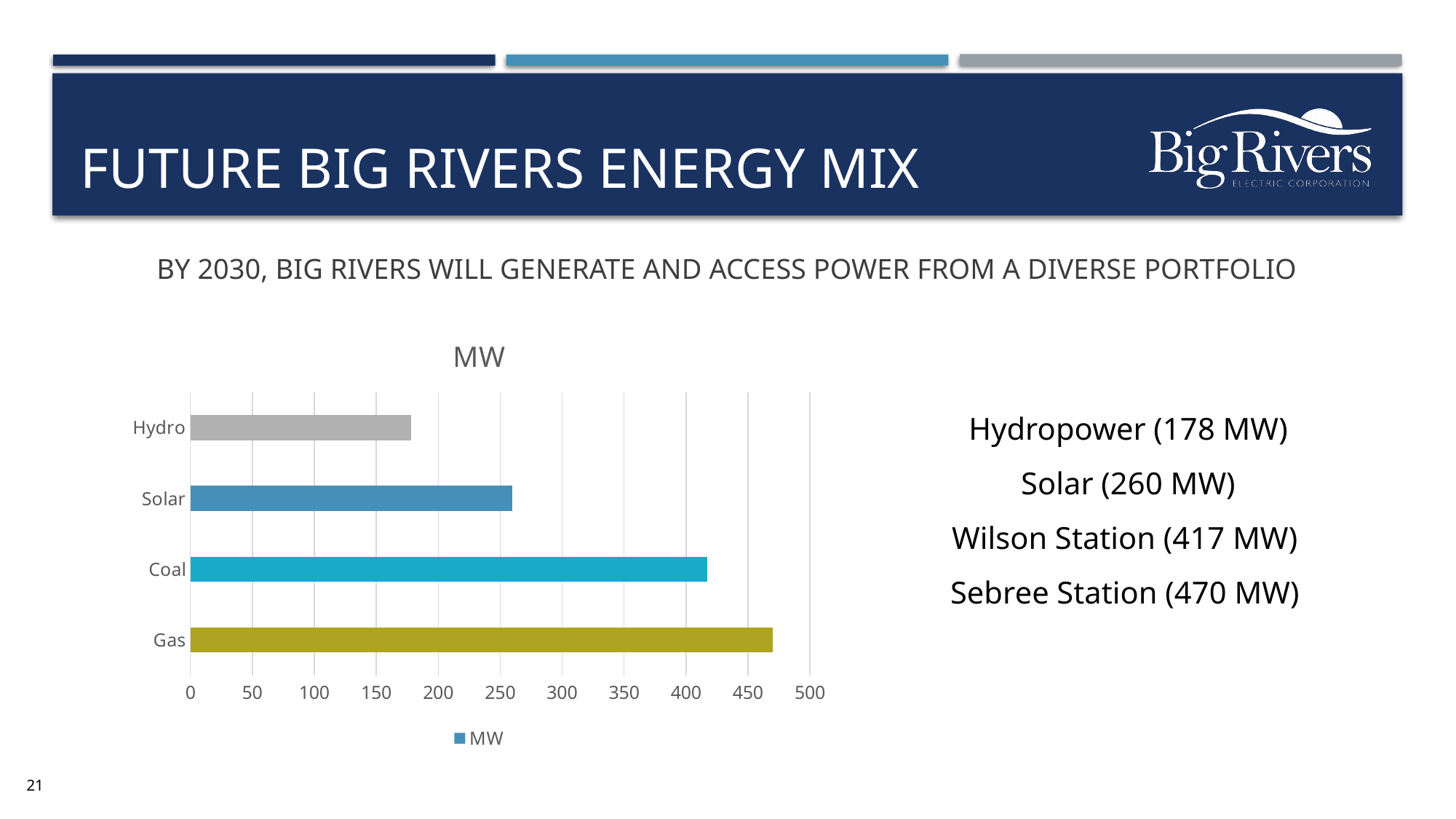
Which is larger in the MW chart, Coal or Solar? Coal Is the value for Hydro greater or less than 200? less How many categories are plotted in the MW chart? 4 Is the value for Solar greater or less than 300? less Is the value for Coal greater or less than 400? greater What is the title of the chart? MW How many series does the legend of the MW chart list? 1 Which category has the highest value in the MW chart? Gas Which category has the lowest value in the MW chart? Hydro What type of chart is shown on the slide? bar chart What is the legend entry shown below the chart? MW